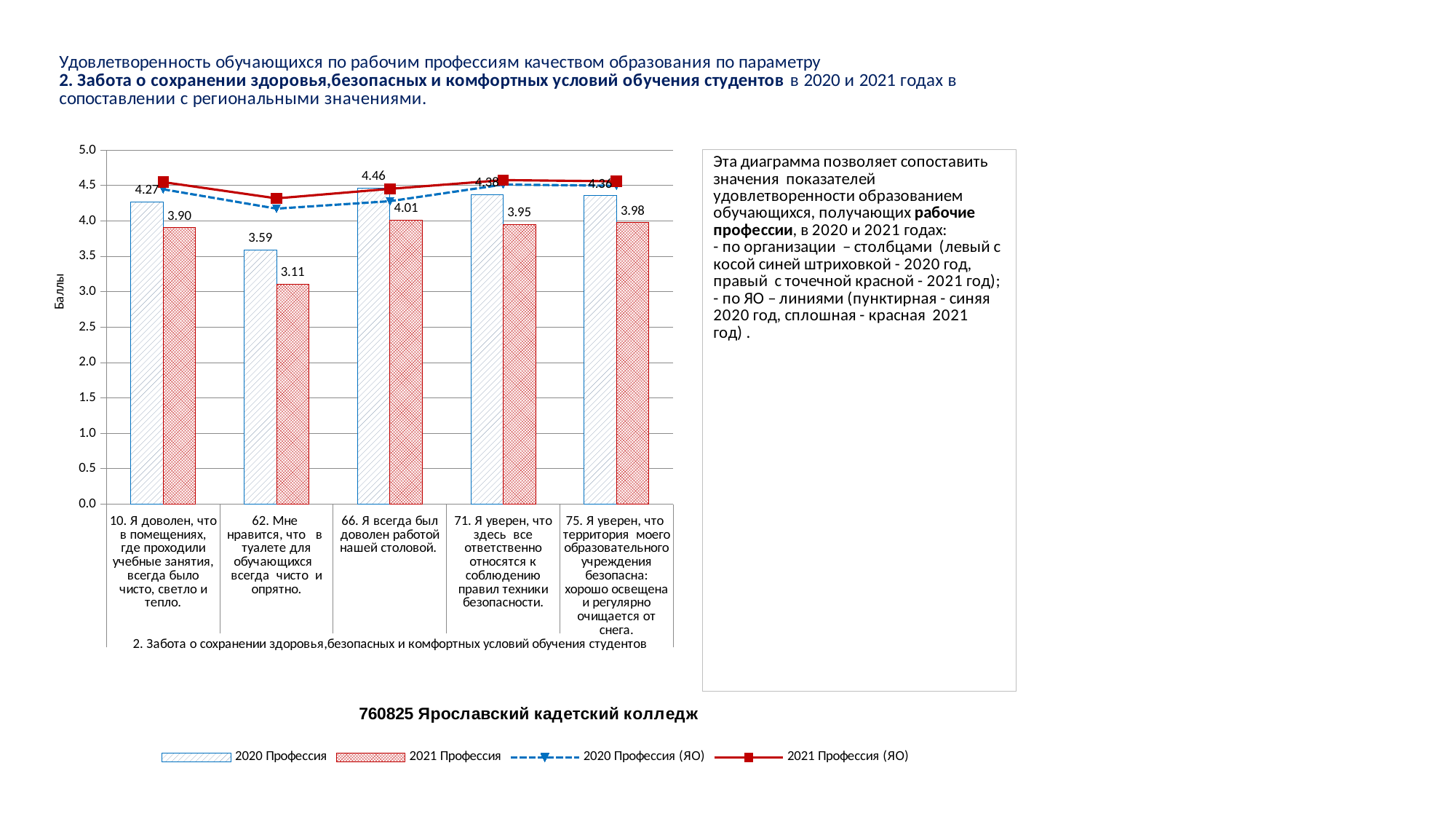
Which question has the lowest 2020 Профессия bar? 62. Мне нравится, что в туалете для обучающихся всегда чисто и опрятно. What is the label of the vertical axis of the chart? Баллы What is the value of the 2020 Профессия bar for question 10 (Я доволен, что в помещениях, где проходили учебные занятия, всегда было чисто, светло и тепло)? 4.27 Is the value of the 2021 Профессия (ЯО) line for question 62 greater or less than 4.0? greater What is the difference between the 2020 Профессия and 2021 Профессия values for question 62? 0.48 How many questions (categories) are shown on the x axis of the chart? 5 How many series does the chart legend list? 4 Which is larger for question 10: the 2020 Профессия bar or the 2021 Профессия bar? 2020 Профессия Which question has the lowest 2021 Профессия bar? 62. Мне нравится, что в туалете для обучающихся всегда чисто и опрятно. What is the value of the 2021 Профессия bar for question 62 (Мне нравится, что в туалете для обучающихся всегда чисто и опрятно)? 3.11 What is the value of the 2021 Профессия bar for question 75 (Я уверен, что территория моего образовательного учреждения безопасна)? 3.98 What is the value of the 2020 Профессия bar for question 66 (Я всегда был доволен работой нашей столовой)? 4.46